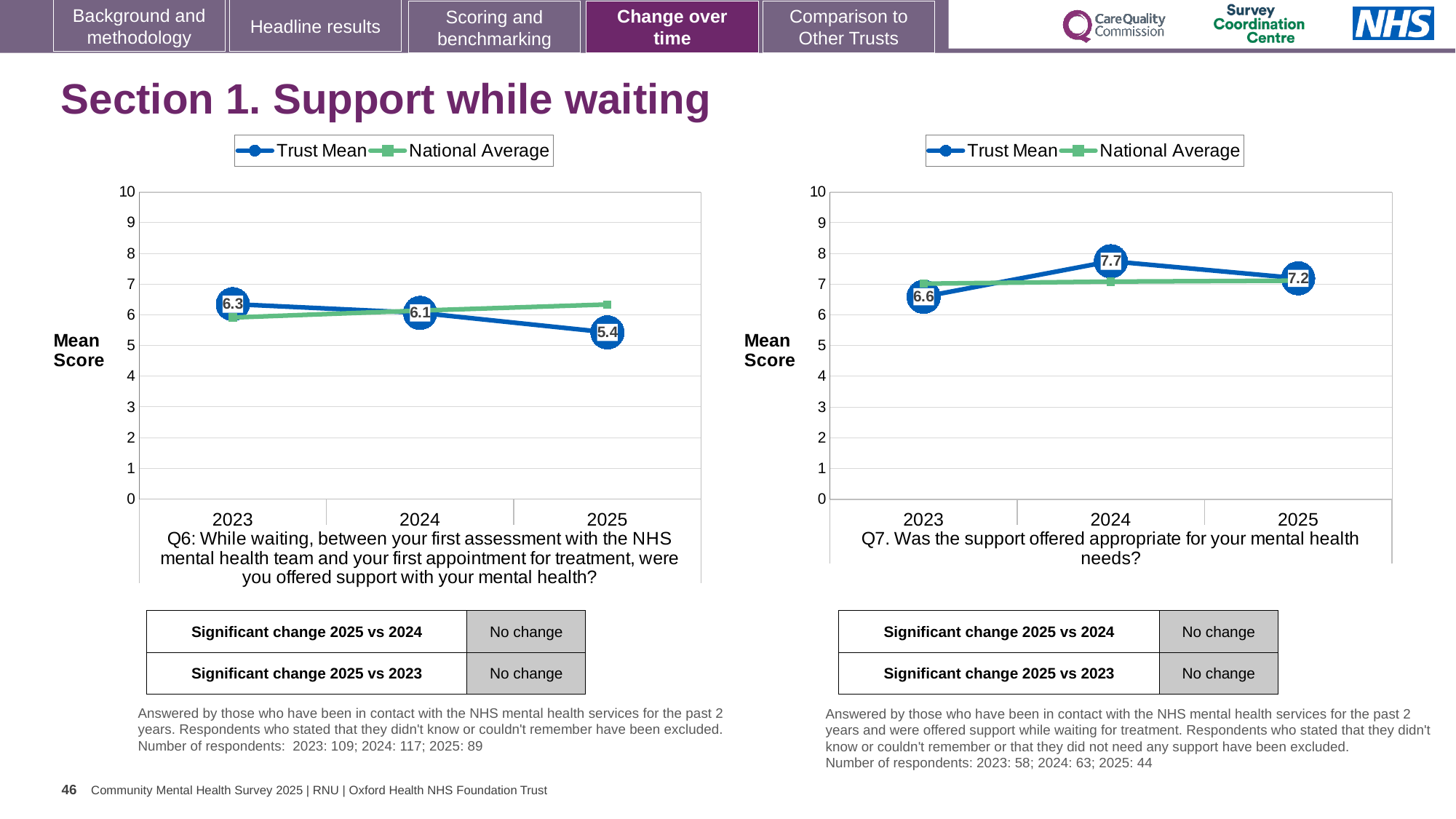
How many series does the legend of the right chart (Q7) list? 2 In the left chart (Q6), does the Trust Mean rise or fall from 2023 to 2025? fall In the right chart (Q7), what is the Trust Mean score for 2024? 7.7 In the left chart (Q6), what is the Trust Mean score for 2025? 5.4 In the left chart (Q6), what is the Trust Mean score for 2023? 6.3 In the left chart (Q6), what is the difference between the Trust Mean scores for 2023 and 2025? 0.9 In the right chart (Q7), what is the difference between the Trust Mean scores for 2024 and 2023? 1.1 In the right chart (Q7), which year has the highest Trust Mean score? 2024 In the left chart (Q6), is the National Average for 2025 greater or less than 6? greater What type of chart is the left chart (Q6)? line chart In the left chart (Q6), which year has the lowest Trust Mean score? 2025 In the right chart (Q7), what is the Trust Mean score for 2025? 7.2